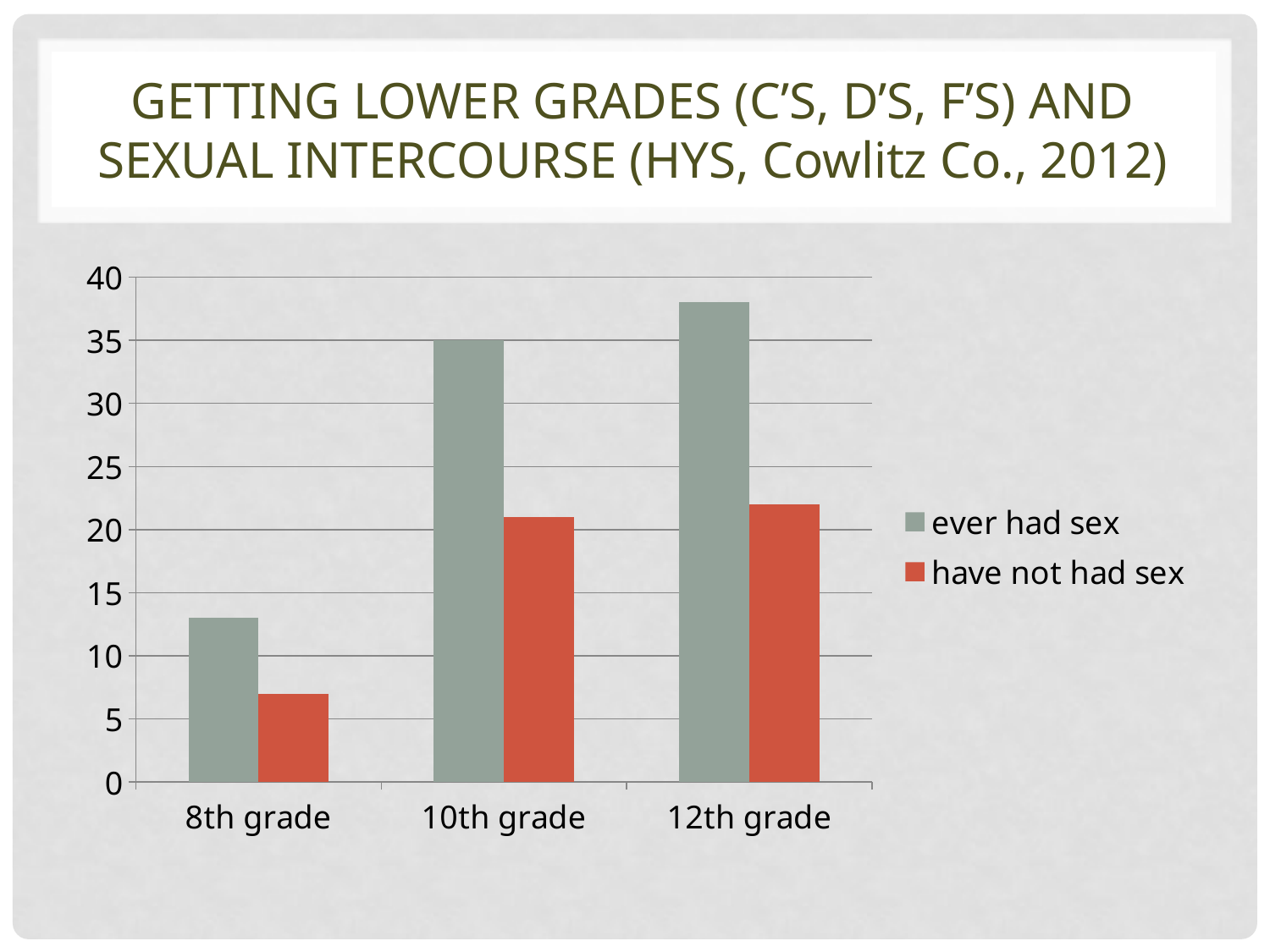
Do the values for the 'ever had sex' series rise or fall from 8th grade to 12th grade? rise What kind of chart is shown on the slide? bar chart Which is larger: 'ever had sex' in 10th grade or 'have not had sex' in 10th grade? ever had sex in 10th grade Which grade has the lowest value for the 'have not had sex' series? 8th grade How many series does the legend list? 2 Is the value for 'ever had sex' in 8th grade greater or less than 15? less Is the value for 'have not had sex' in 8th grade greater or less than 10? less Which colour represents the 'have not had sex' series in the legend? red Is the value for 'have not had sex' in 12th grade greater or less than 20? greater How many grade categories are shown on the x axis? 3 Which grade has the highest value for the 'ever had sex' series? 12th grade